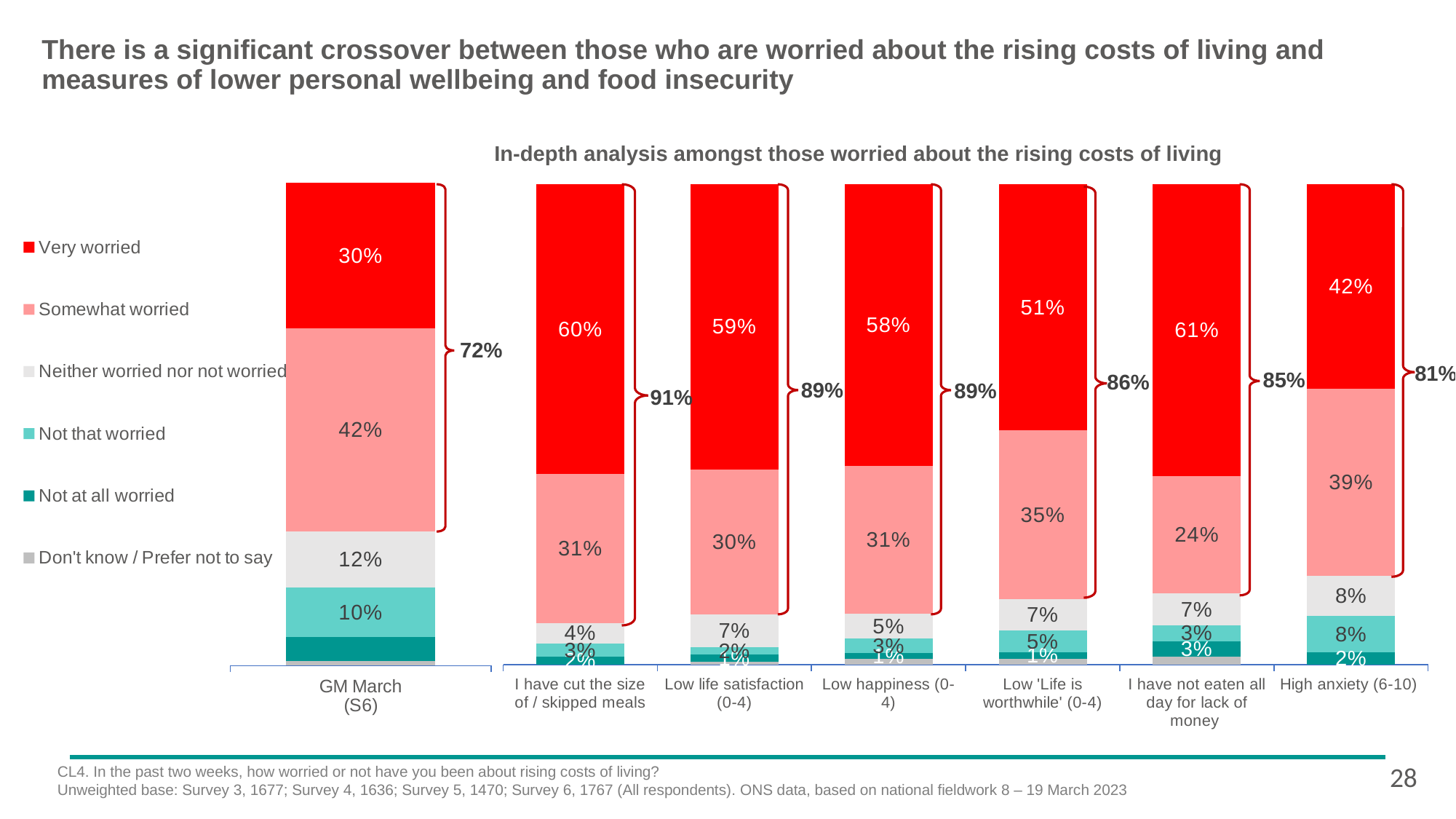
What is the combined 'Very worried' and 'Somewhat worried' percentage shown by the bracket for Low happiness (0-4)? 89% Which category has the lowest 'Very worried' percentage? GM March (S6) Which category has the highest 'Very worried' percentage? I have not eaten all day for lack of money How many series does the legend list? 6 What is the 'Somewhat worried' value for the High anxiety (6-10) group? 39% What percentage of respondents who have not eaten all day for lack of money are 'Very worried'? 61% Which has a larger 'Somewhat worried' share: GM March (S6) or Low 'Life is worthwhile' (0-4)? GM March (S6) How many categories (bars) are shown in the chart? 7 What is the difference in the 'Very worried' percentage between High anxiety (6-10) and GM March (S6)? 12 percentage points What type of chart is shown on the slide? Stacked bar chart What is the 'Neither worried nor not worried' value for GM March (S6)? 12% What colour represents 'Very worried' in the legend? Red